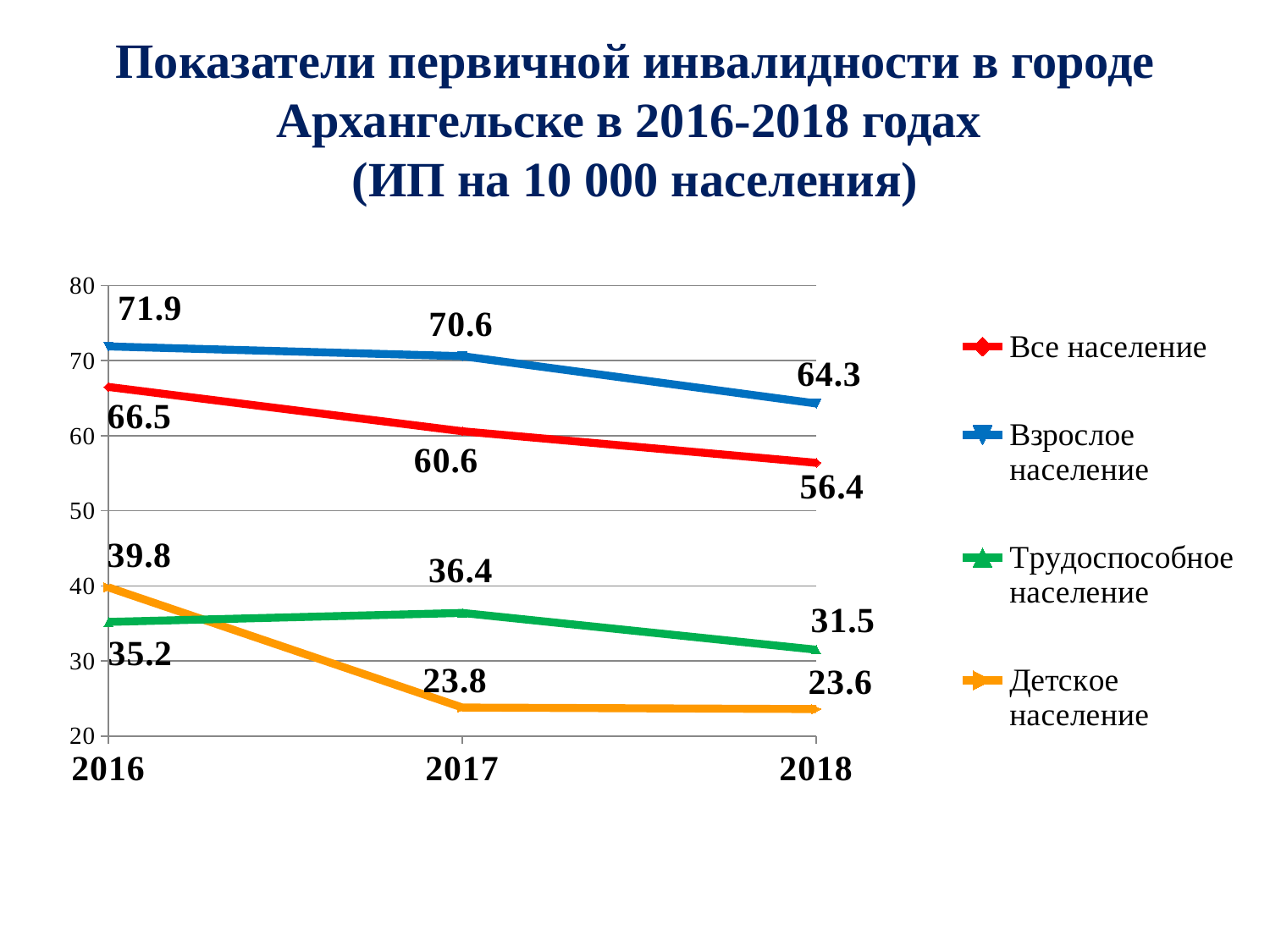
What is the value for Все население in 2018? 56.4 Which colour is used for the Трудоспособное население line? green What type of chart is shown on the slide? line chart How many series does the legend list? 4 Which series has the lowest value in 2016? Трудоспособное население Which series has the highest value in 2018? Взрослое население Does the Детское население line rise or fall from 2016 to 2018? fall What is the value for Трудоспособное население in 2017? 36.4 What is the value for Взрослое население in 2016? 71.9 What is the difference between the Все население values in 2016 and 2018? 10.1 What is the value for Детское население in 2017? 23.8 How many years are shown on the x axis? 3